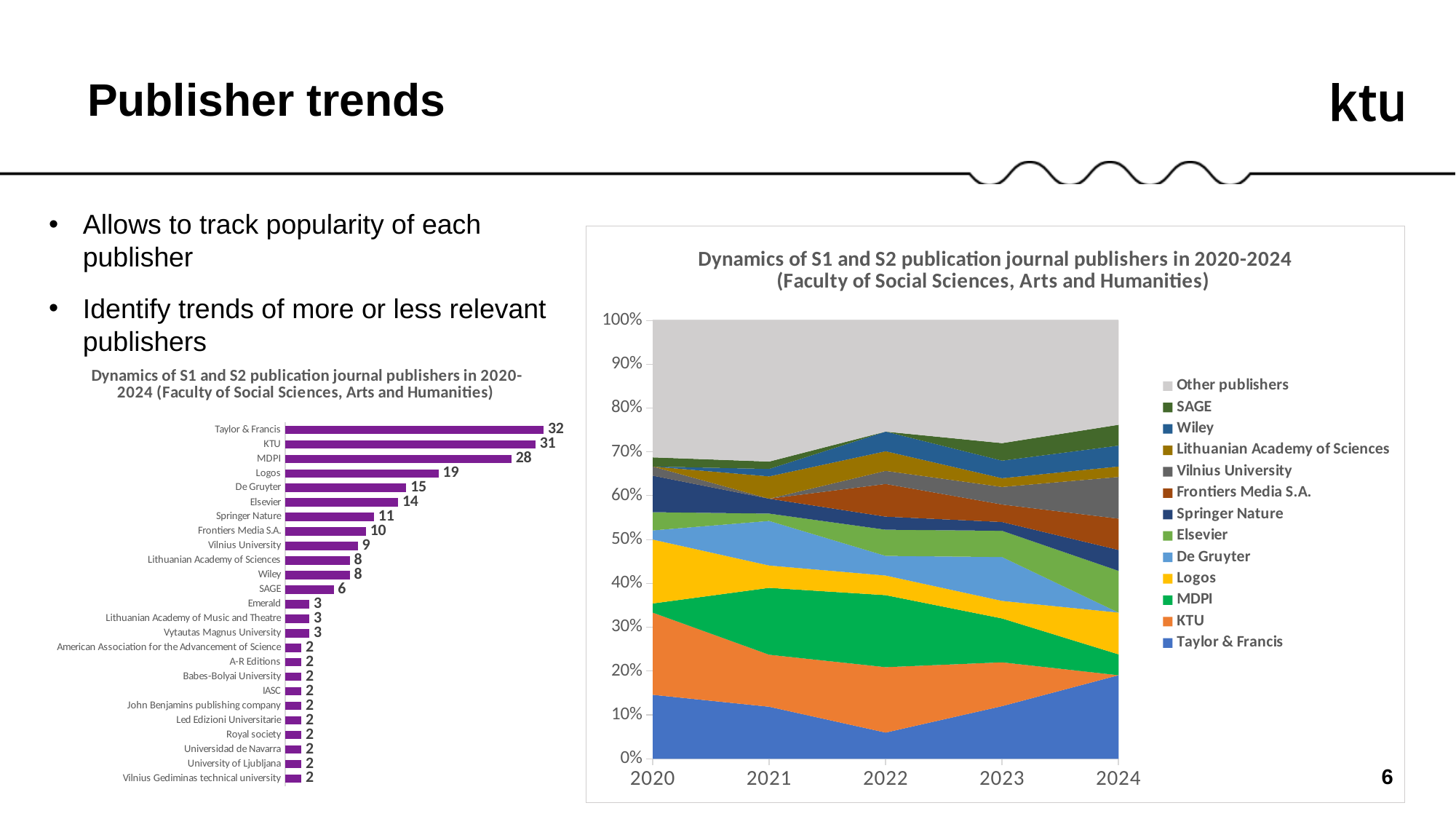
What kind of chart is the chart on the left of the slide? Bar chart On the left bar chart, which publisher has the highest value? Taylor & Francis On the left bar chart, what is the value for Taylor & Francis? 32 On the left bar chart, what is the value for SAGE? 6 On the left bar chart, what is the value for Logos? 19 On the right chart, how many series does the legend list? 13 On the right chart, how many years are shown on the x axis? 5 On the left bar chart, what is the difference between the values for KTU and MDPI? 3 On the left bar chart, how many publishers are listed? 25 On the right chart, does the share for Taylor & Francis rise or fall from 2022 to 2024? rise On the left bar chart, which is larger, the value for De Gruyter or the value for Elsevier? De Gruyter On the right chart, is the share for Taylor & Francis in 2022 greater or less than 10%? less